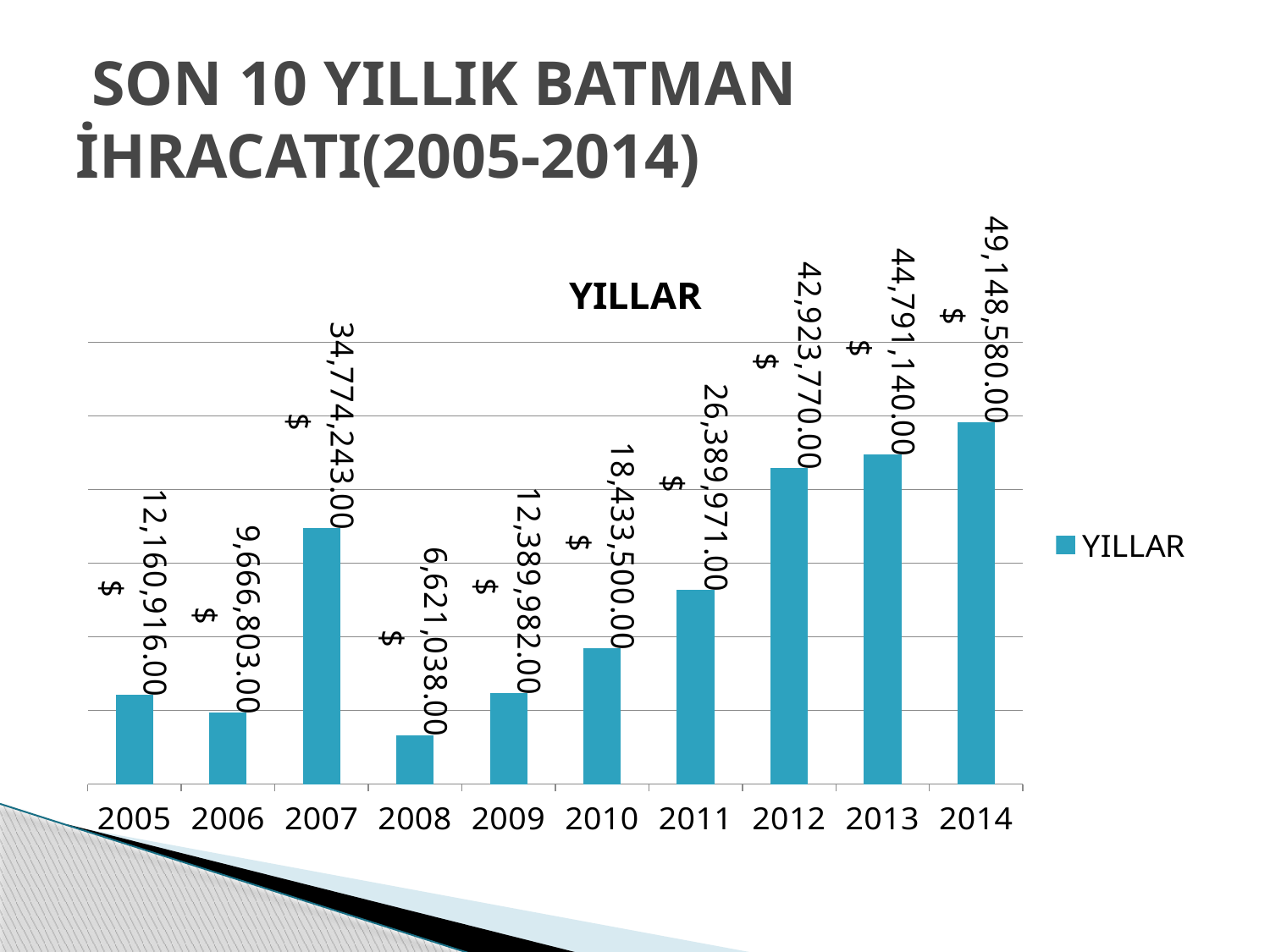
How many years are shown on the x axis? 10 What is the difference between the values for 2014 and 2013? 4,357,440.00 $ What is the value for 2014? 49,148,580.00 $ What is the title of the chart? YILLAR What kind of chart is this? Bar chart Which is larger, the value for 2009 or the value for 2005? 2009 What is the value for 2008? 6,621,038.00 $ What is the value for 2011? 26,389,971.00 $ What is the difference between the values for 2007 and 2006? 25,107,440.00 $ What is the value for 2007? 34,774,243.00 $ Which year has the lowest value? 2008 Which year has the highest value? 2014